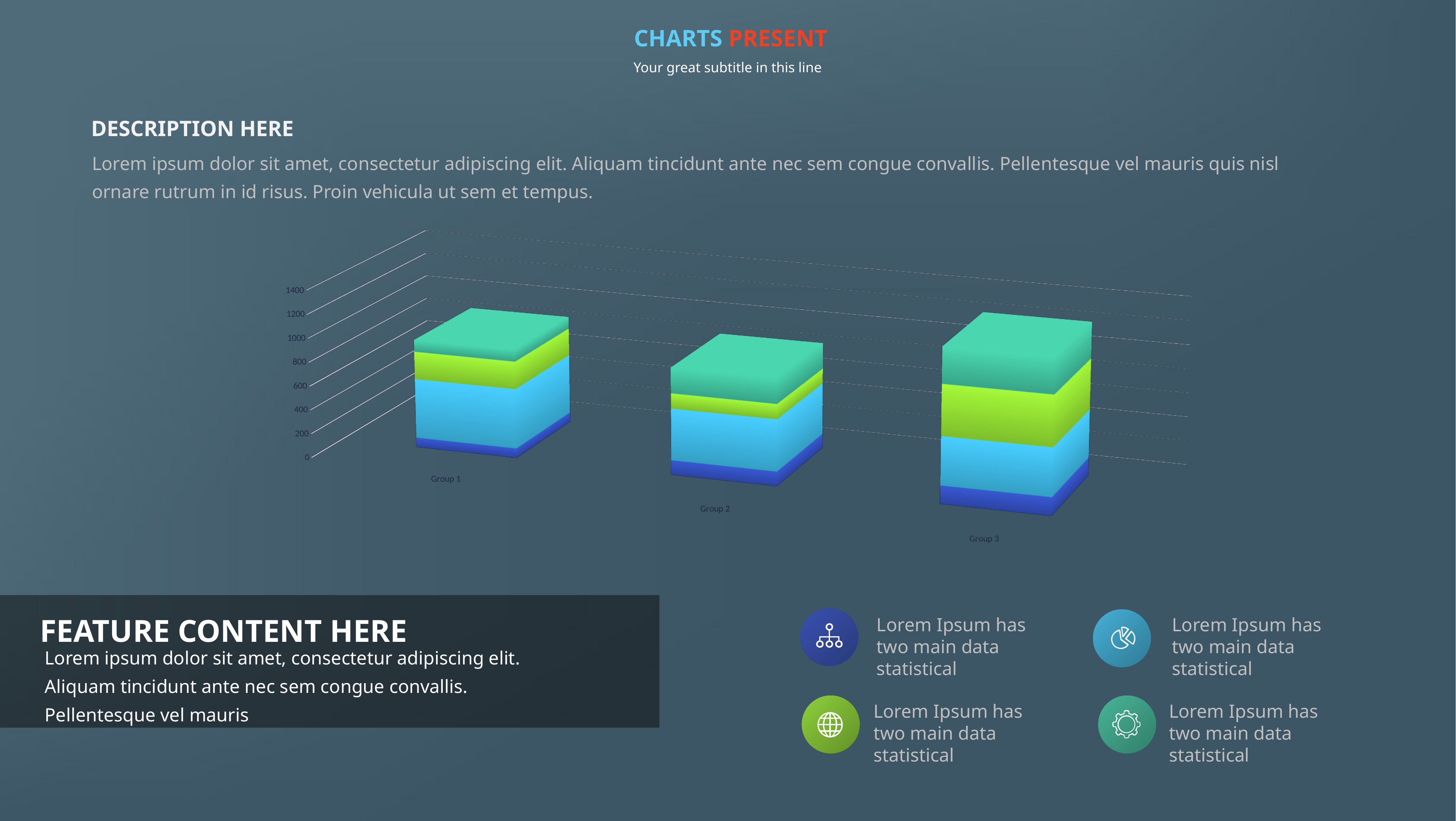
How many groups (categories) are plotted on the x axis of the chart? 3 Is the total value for Group 3 greater or less than 1000? greater How many coloured segments make up each stacked bar in the chart? 4 Which stacked bar is taller, Group 1 or Group 3? Group 3 Is the total value for Group 2 greater or less than 400? greater What is the highest value labelled on the chart's vertical axis? 1400 Is the total value for Group 1 greater or less than 1200? less Which group has the tallest stacked bar in the chart? Group 3 What kind of chart is shown on the slide? Stacked bar chart